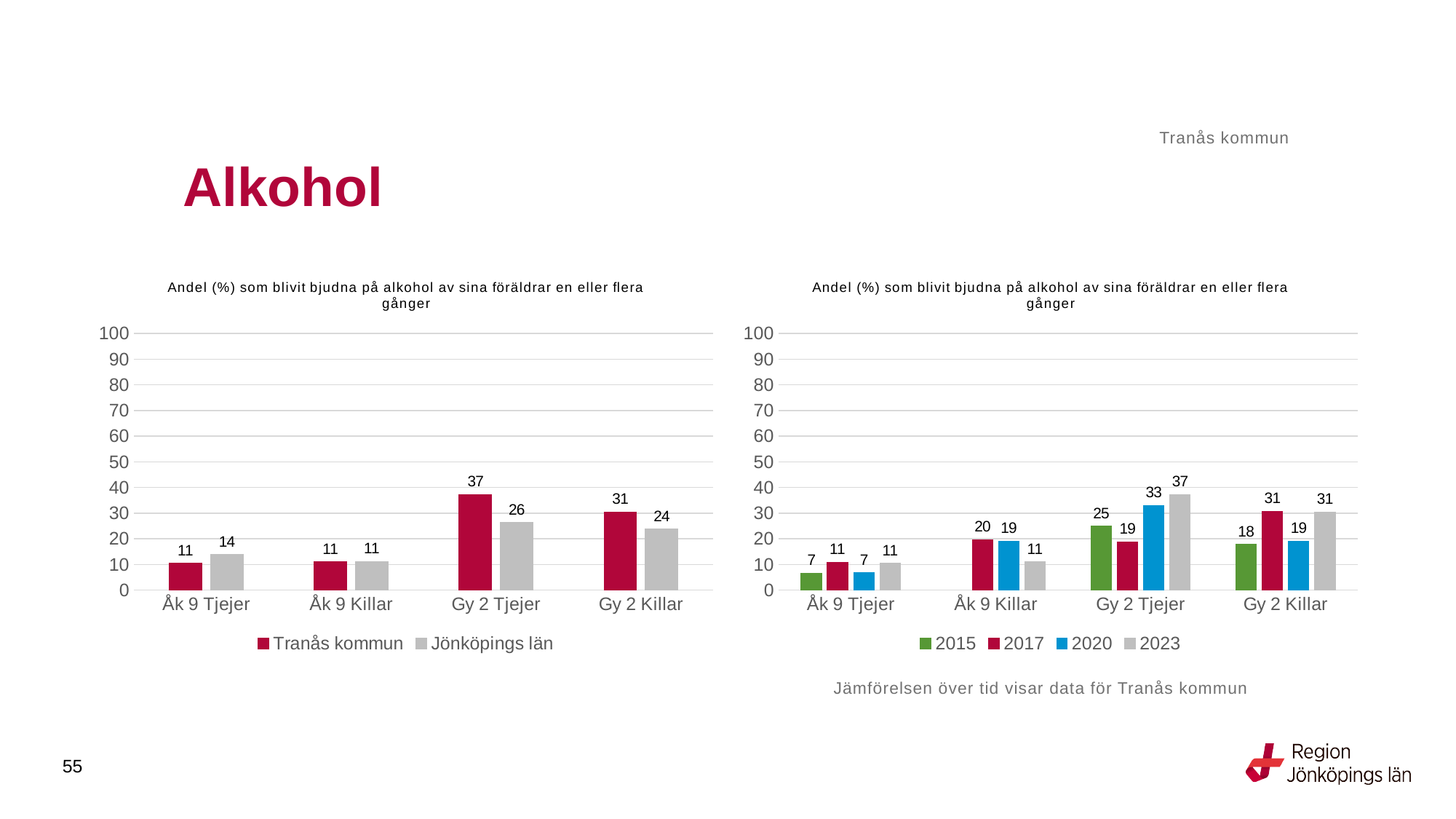
How many series does the legend of the left chart list? 2 In the left chart, what is the difference between Tranås kommun and Jönköpings län for Gy 2 Tjejer? 11 In the left chart, what is the value for Tranås kommun for Gy 2 Tjejer? 37 How many series does the legend of the right chart list? 4 In the right chart, which year has the lowest value for Åk 9 Killar? 2023 In the right chart, what is the value for 2015 for Åk 9 Tjejer? 7 In the left chart, which category has the highest value for Tranås kommun? Gy 2 Tjejer What type of chart is the right chart? Bar chart In the right chart, what is the value for 2023 for Gy 2 Tjejer? 37 In the left chart, which is larger for Åk 9 Tjejer: Tranås kommun or Jönköpings län? Jönköpings län In the right chart, what is the difference between 2017 and 2023 for Gy 2 Tjejer? 18 In the left chart, what is the value for Jönköpings län for Gy 2 Killar? 24